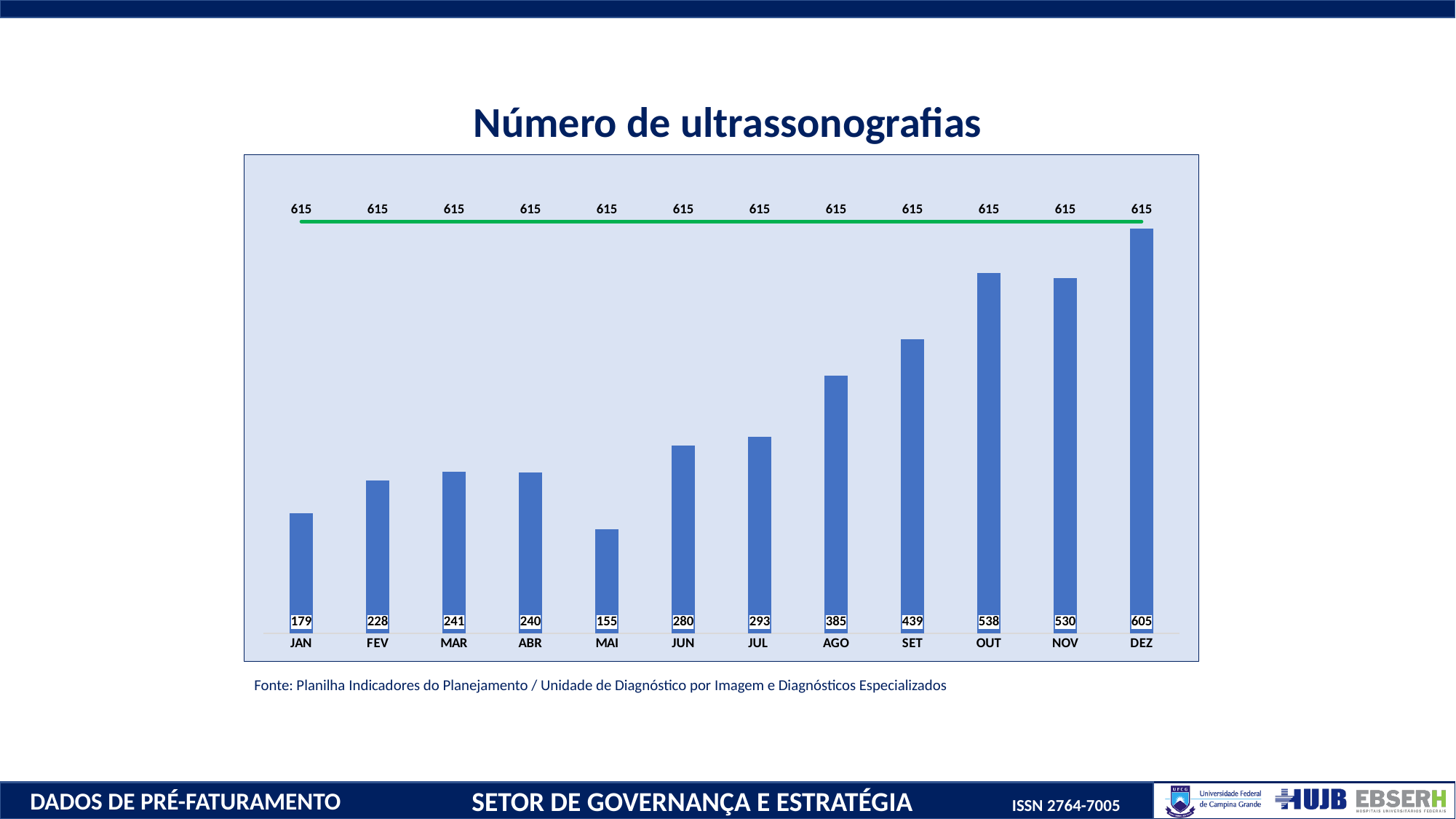
What is the difference between the green line value and the bar value for DEZ? 10 What is the difference between the values for DEZ and JAN? 426 How many months are shown on the x axis? 12 What is the value of the green line for each month? 615 Which is larger, the value for MAR or the value for ABR? MAR Which is larger, the value for OUT or the value for NOV? OUT Which month has the lowest bar? MAI Which month has the highest bar? DEZ What is the number of ultrasonographies shown for AGO? 385 What value does the bar for MAI show? 155 What kind of chart is shown on the slide? Bar chart What is the title of the chart? Número de ultrassonografias